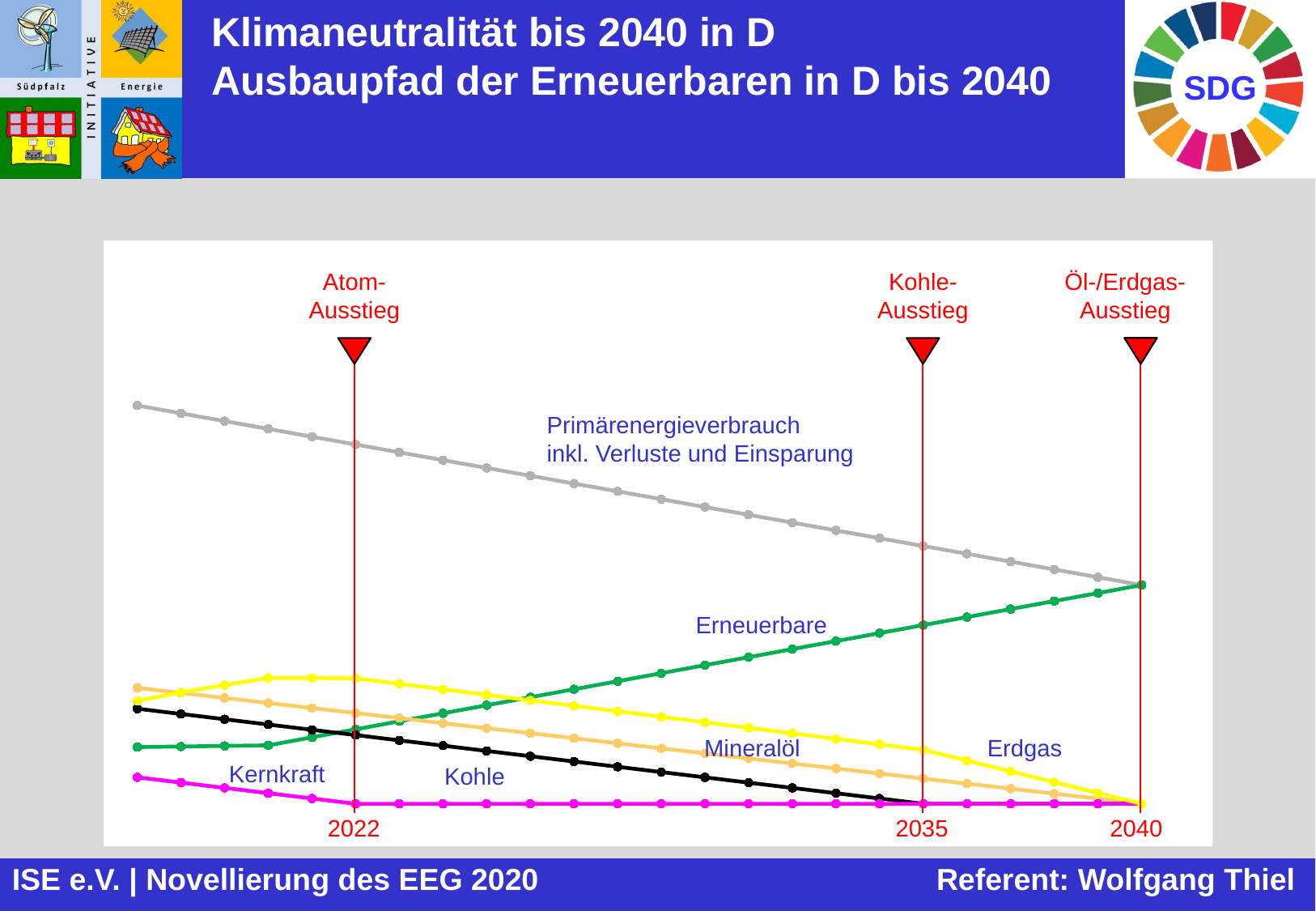
In which year does the Kernkraft line reach the bottom of the chart? 2022 Does the Primärenergieverbrauch line rise or fall from left to right? fall How many year labels are shown on the x axis? 3 Does the Kohle line rise or fall between 2022 and 2035? fall Which year is marked with the Kohle-Ausstieg marker? 2035 In which year does the Kohle line reach the bottom of the chart? 2035 What kind of chart is shown on the slide? line chart At 2035, which is larger: Erneuerbare or Erdgas? Erneuerbare At 2035, which is larger: Primärenergieverbrauch or Erneuerbare? Primärenergieverbrauch Does the Erneuerbare line rise or fall from left to right? rise How many labelled data series are plotted in the chart? 6 Which series has the highest value at the left edge of the chart? Primärenergieverbrauch